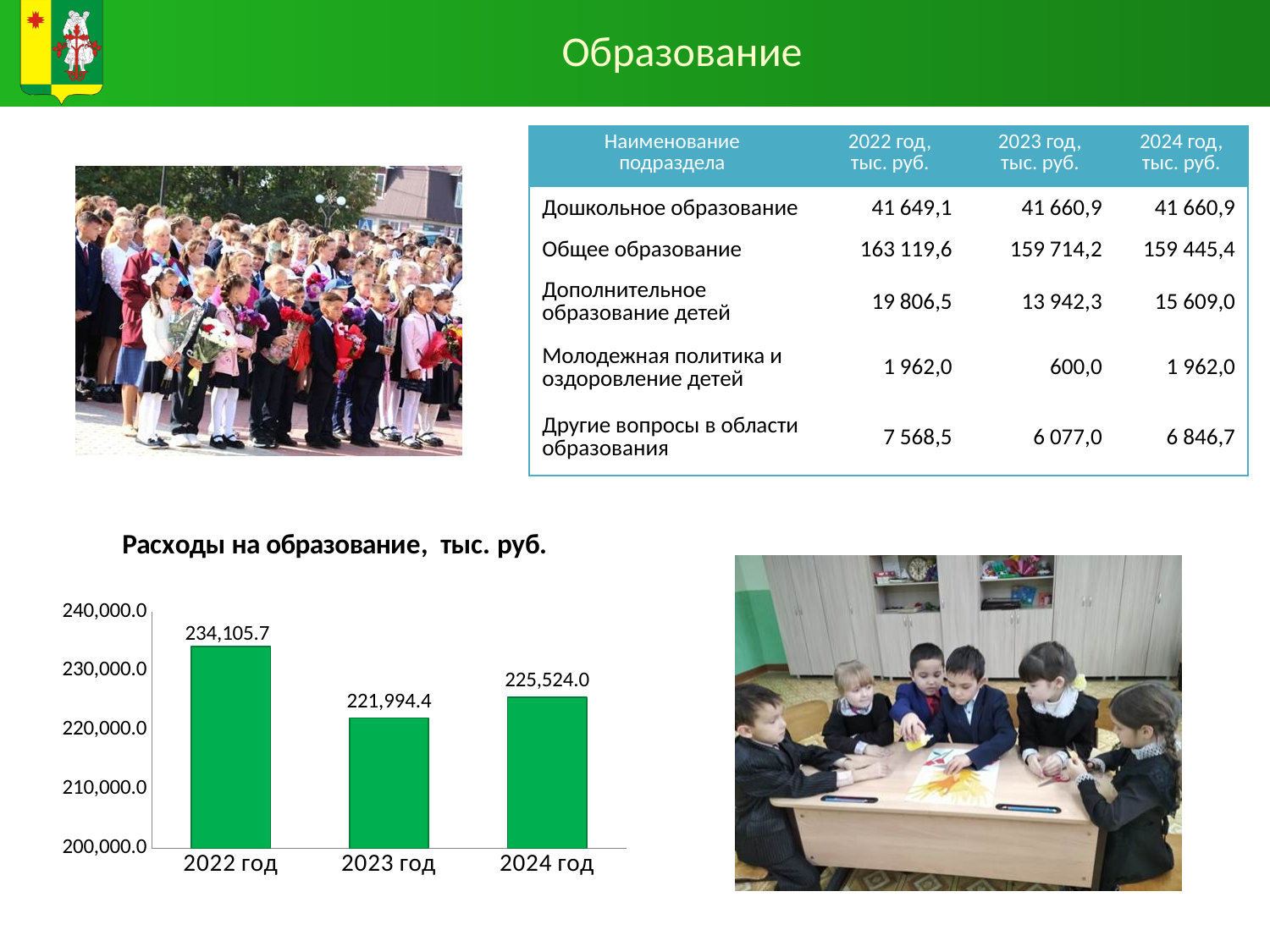
What is the value for 2024 год in the chart 'Расходы на образование, тыс. руб.'? 225,524.0 What is the value for 2023 год in the chart 'Расходы на образование, тыс. руб.'? 221,994.4 In the chart 'Расходы на образование, тыс. руб.', what is the difference between the values for 2022 год and 2023 год? 12,111.3 Which year has the lowest value in the chart 'Расходы на образование, тыс. руб.'? 2023 год In the chart 'Расходы на образование, тыс. руб.', which is larger: the value for 2023 год or 2024 год? 2024 год What is the value for 2022 год in the chart 'Расходы на образование, тыс. руб.'? 234,105.7 What is the title of the chart on the slide? Расходы на образование, тыс. руб. In the chart 'Расходы на образование, тыс. руб.', what is the difference between the values for 2024 год and 2023 год? 3,529.6 How many bars are shown in the chart 'Расходы на образование, тыс. руб.'? 3 Which year has the highest value in the chart 'Расходы на образование, тыс. руб.'? 2022 год What type of chart is 'Расходы на образование, тыс. руб.'? bar chart In the chart 'Расходы на образование, тыс. руб.', is the value for 2022 год greater or less than 230,000.0? greater